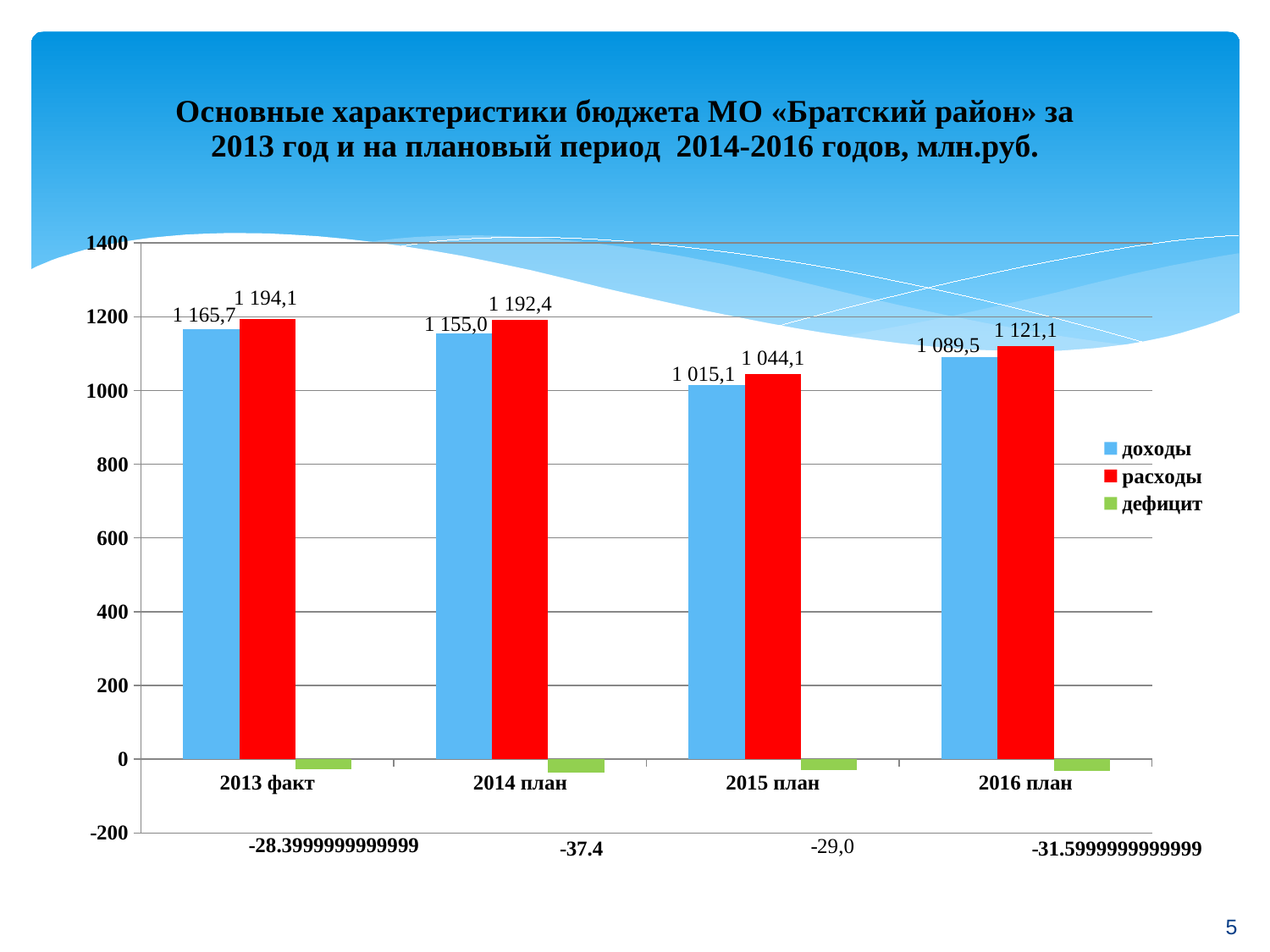
What is the value of дефицит for 2014 план? -37.4 What is the value of доходы for 2013 факт? 1 165,7 In which category is доходы the highest? 2013 факт What type of chart is shown on the slide? bar chart What is the value of доходы for 2015 план? 1 015,1 What is the difference between расходы and доходы for 2015 план? 29,0 In which category is расходы the lowest? 2015 план How many series does the legend list? 3 What is the value of расходы for 2014 план? 1 192,4 Which is larger for 2016 план, доходы or расходы? расходы What is the value of расходы for 2016 план? 1 121,1 How many categories are shown on the x axis? 4